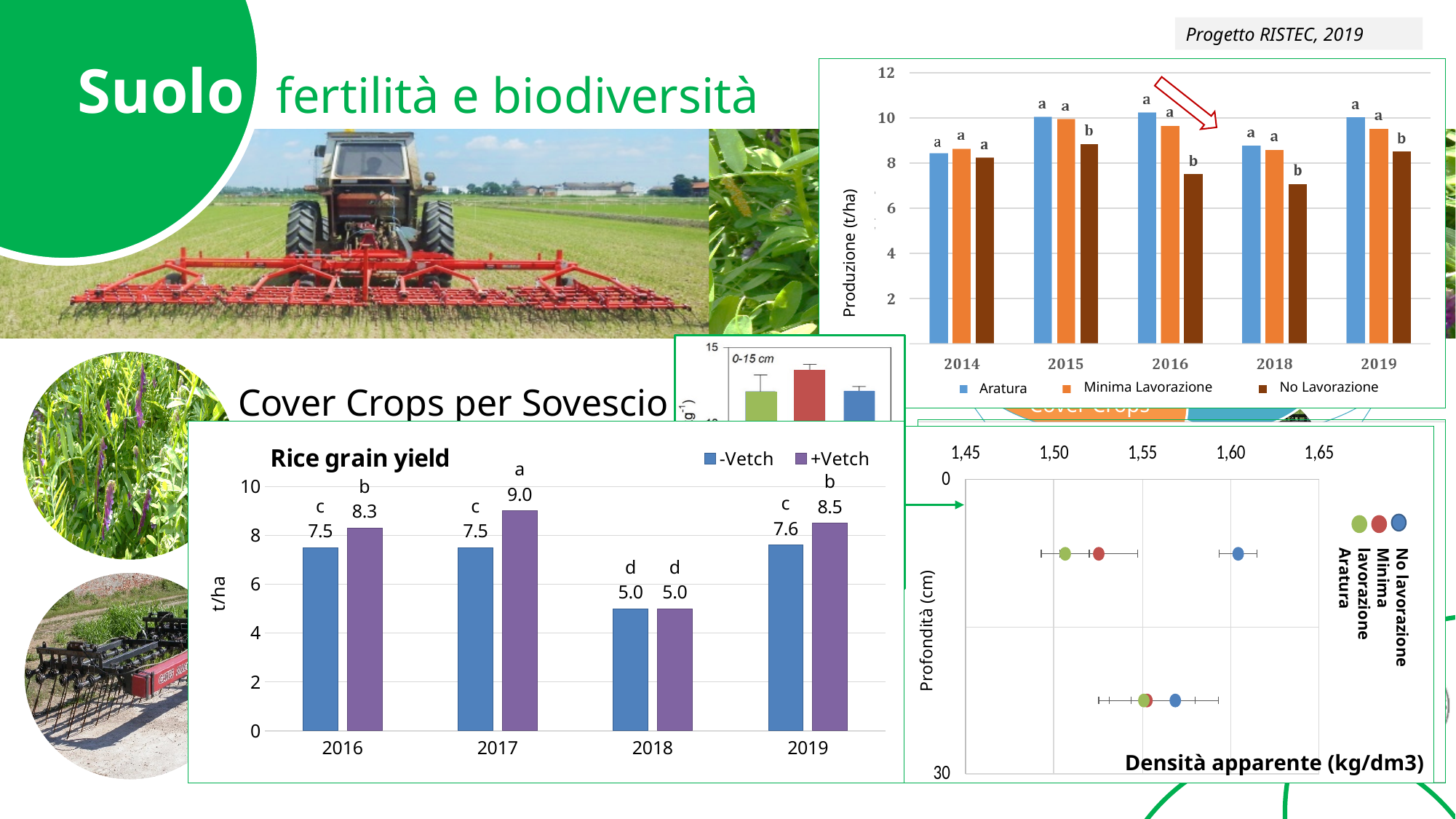
In the 'Rice grain yield' chart, what is the value for -Vetch in 2019? 7.6 What kind of chart is the bottom-right chart with the x axis 'Densità apparente (kg/dm3)'? scatter chart In the 'Rice grain yield' chart, what is the difference between the +Vetch and -Vetch values in 2016? 0.8 In the top-right chart (Produzione t/ha), how many years are shown on the x axis? 5 In the 'Rice grain yield' chart, which year has the highest +Vetch value? 2017 In the top-right chart (Produzione t/ha), is the value for Aratura in 2014 greater or less than 8? greater In the 'Rice grain yield' chart, what is the value for +Vetch in 2017? 9.0 In the 'Rice grain yield' chart, which is larger in 2019: the -Vetch value or the +Vetch value? +Vetch In the top-right chart (Produzione t/ha), is the value for No Lavorazione in 2018 greater or less than 8? less How many series does the legend of the top-right chart (Produzione t/ha) list? 3 How many series does the legend of the 'Rice grain yield' chart list? 2 In the 'Rice grain yield' chart, which year has the lowest -Vetch value? 2018